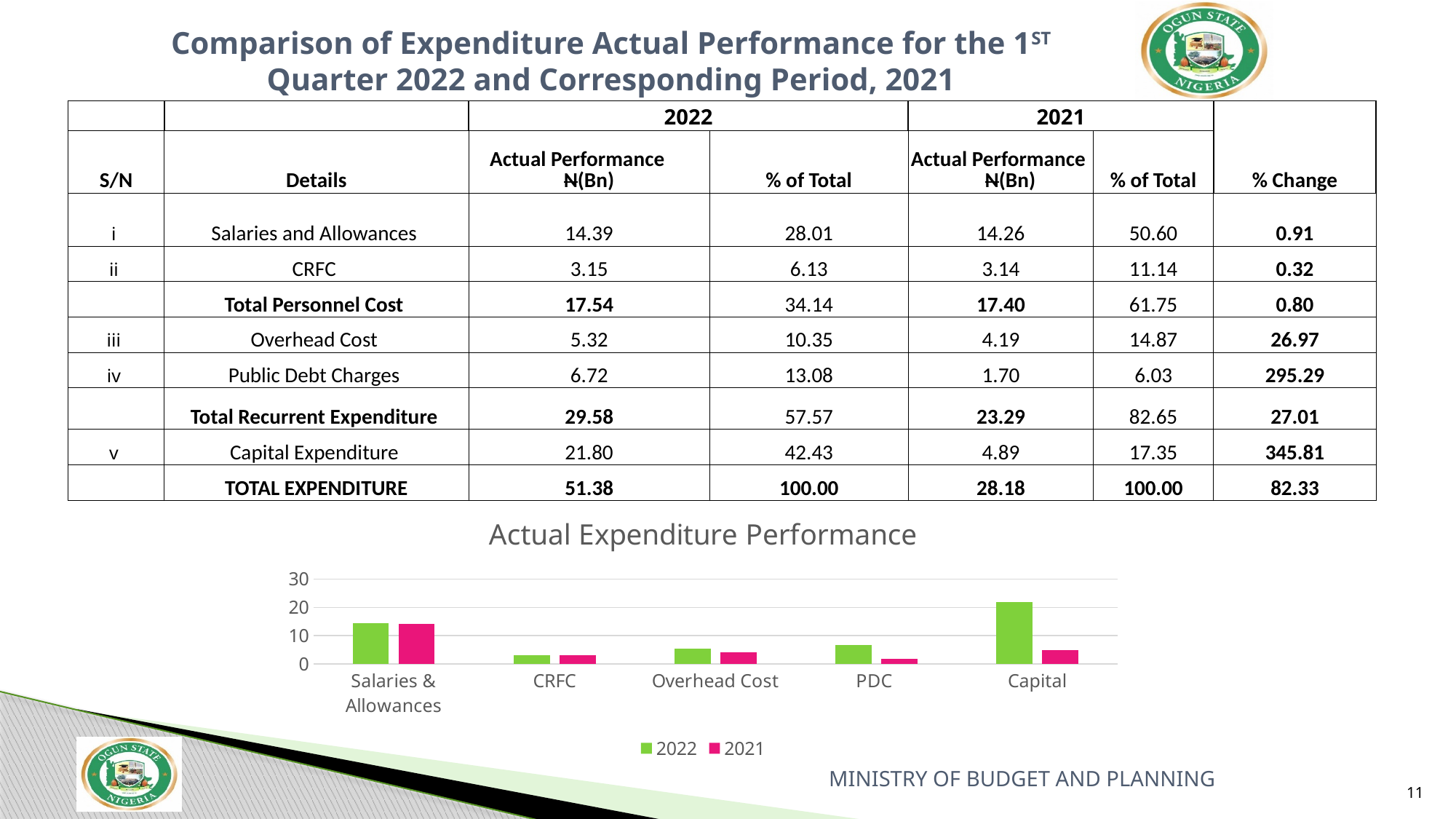
In the "Actual Expenditure Performance" chart, what colour are the 2022 bars? green How many categories are shown on the x axis of the "Actual Expenditure Performance" chart? 5 What is the title of the chart at the bottom of the slide? Actual Expenditure Performance How many series does the legend of the "Actual Expenditure Performance" chart list? 2 In the "Actual Expenditure Performance" chart, is the 2021 value for Salaries & Allowances greater or less than 10? greater In the "Actual Expenditure Performance" chart, which is larger for PDC: the 2022 bar or the 2021 bar? 2022 What type of chart is shown under the title "Actual Expenditure Performance"? bar chart In the "Actual Expenditure Performance" chart, is the 2022 value for CRFC greater or less than 10? less In the "Actual Expenditure Performance" chart, which category has the lowest 2021 bar? PDC In the "Actual Expenditure Performance" chart, which category has the highest 2022 bar? Capital In the "Actual Expenditure Performance" chart, which is larger for Capital: the 2022 bar or the 2021 bar? 2022 In the "Actual Expenditure Performance" chart, is the 2022 value for Capital greater or less than 20? greater